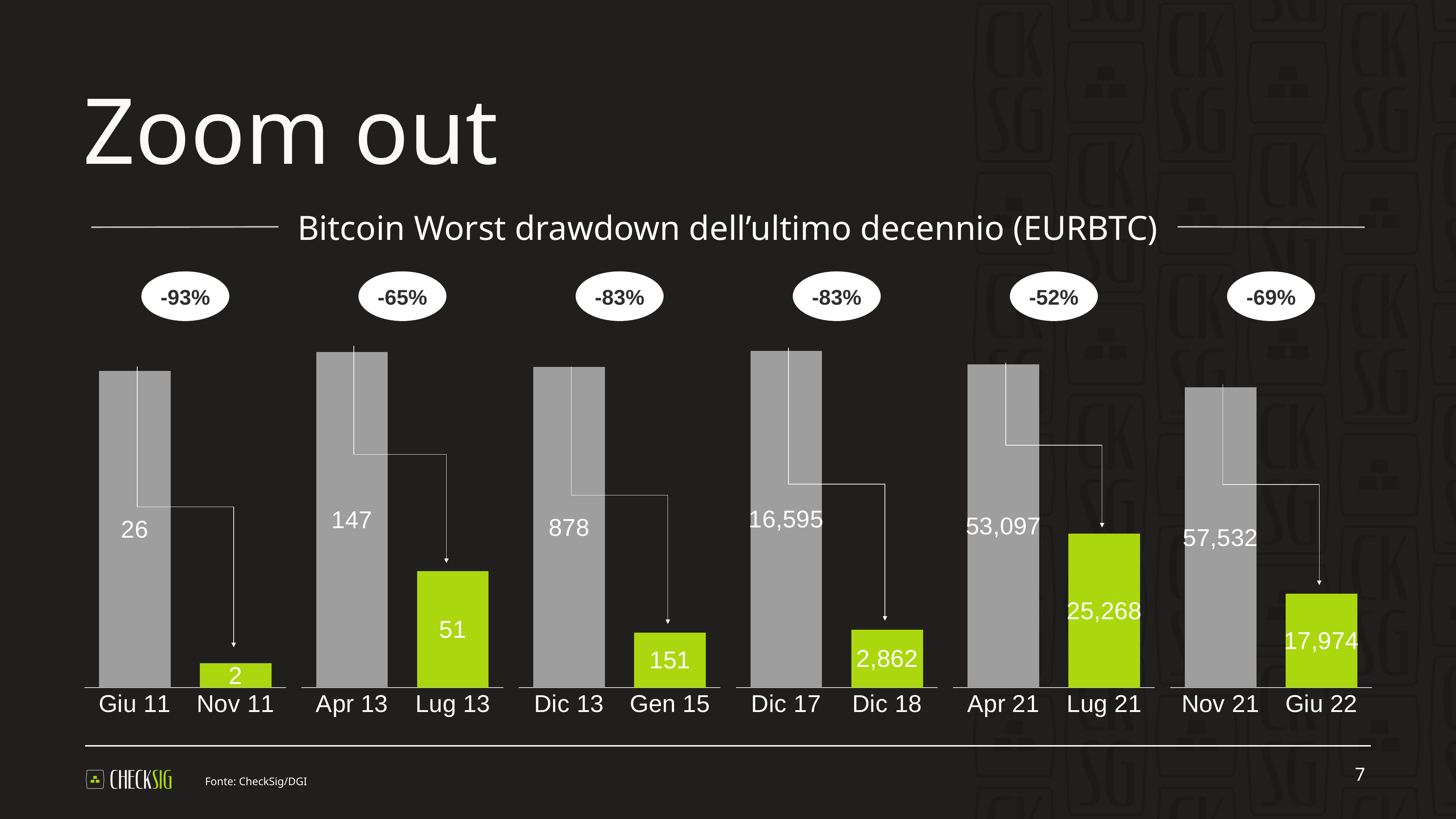
Which drawdown period shows the smallest percentage decline? Apr 21 to Lug 21 (-52%) What is the value for Lug 13 in the Bitcoin Worst drawdown chart? 51 What is the value for Nov 11 in the Bitcoin Worst drawdown chart? 2 What is the value for Giu 22 in the Bitcoin Worst drawdown chart? 17,974 Which is larger, the value for Lug 21 or the value for Giu 22? Lug 21 How many date categories are shown on the x axis of the chart? 12 Which drawdown period shows the largest percentage decline? Giu 11 to Nov 11 (-93%) What is the difference between the Dic 13 value and the Gen 15 value? 727 What is the value for Dic 17 in the Bitcoin Worst drawdown chart? 16,595 What drawdown percentage is shown above the Apr 21 to Lug 21 pair? -52% What is the value for Giu 11 in the Bitcoin Worst drawdown chart? 26 What kind of chart is shown on the slide? Bar chart